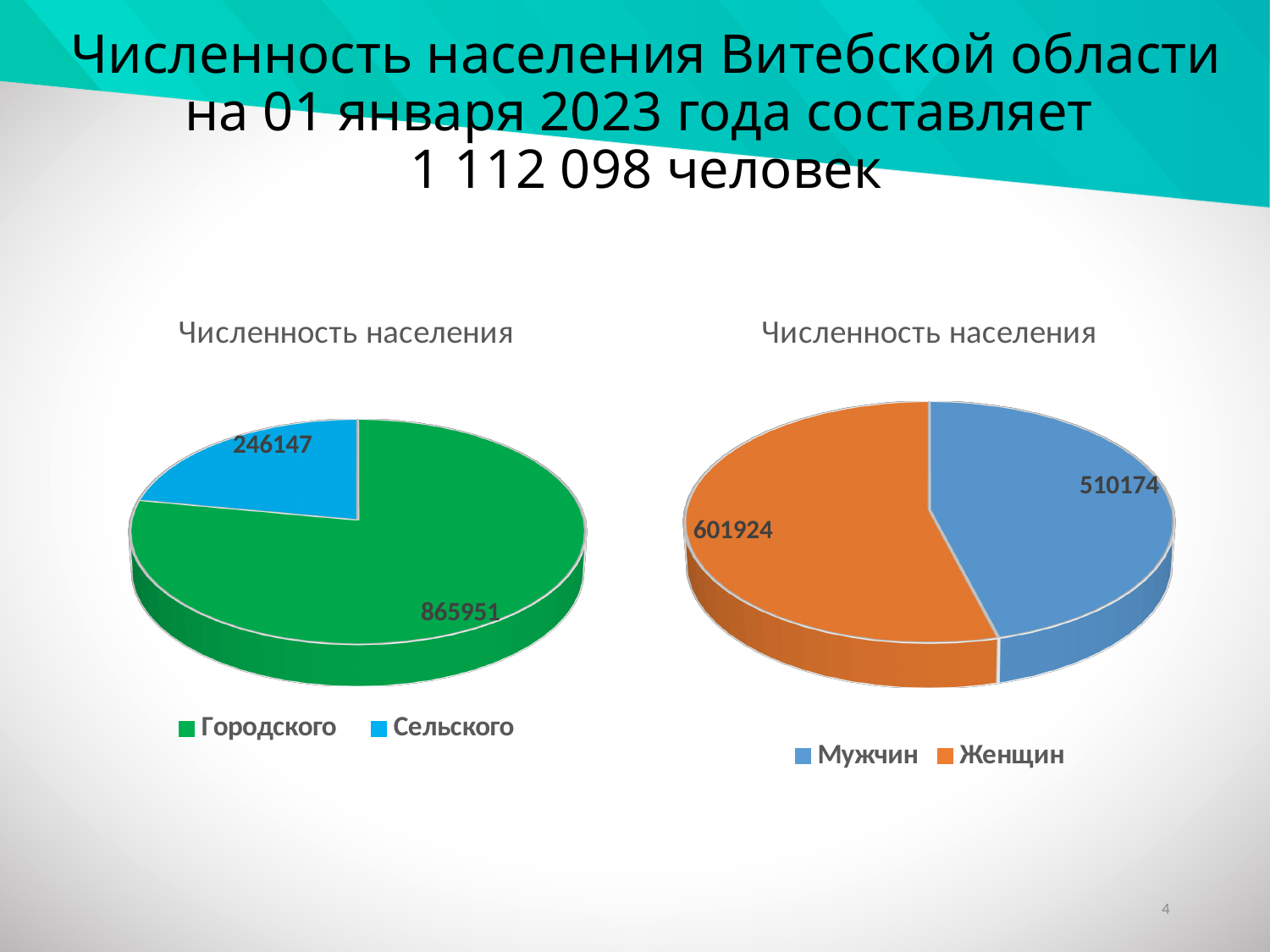
In the right pie chart, which is larger: Мужчин or Женщин? Женщин In the right pie chart, which category has the smallest slice? Мужчин In the left pie chart, what is the difference between the values for Городского and Сельского? 619804 What type of chart is shown on the left of the slide? Pie chart In the left pie chart, what is the value for Городского? 865951 In the left pie chart, what colour is the slice for Сельского? Light blue How many categories does the legend of the right chart list? 2 In the left pie chart, which category has the largest slice? Городского In the right pie chart, what is the value for Женщин? 601924 In the right pie chart, what is the value for Мужчин? 510174 In the left pie chart, what is the value for Сельского? 246147 In the right pie chart, how much larger is the value for Женщин than the value for Мужчин? 91750